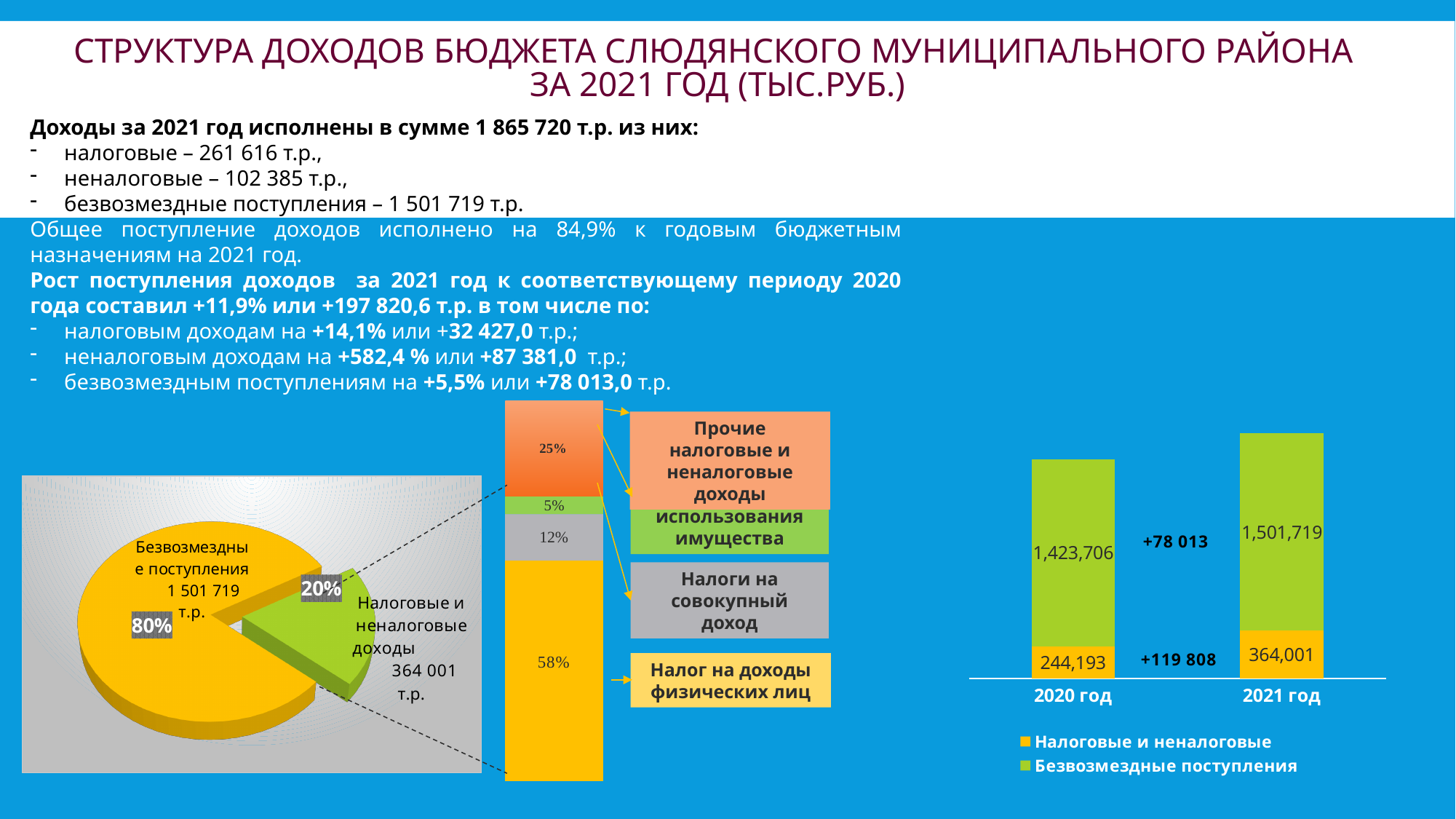
In the bar chart on the right, what is the value for Налоговые и неналоговые in 2020 год? 244,193 How many segments does the stacked bar in the middle of the slide have? 4 What kind of chart is the chart on the left of the slide? Pie chart In the bar chart on the right, by how much did Безвозмездные поступления increase from 2020 год to 2021 год? 78 013 How many series does the legend of the bar chart on the right list? 2 In the pie chart on the left, what value is shown for Налоговые и неналоговые доходы? 364 001 т.р. In the bar chart on the right, do the values for Налоговые и неналоговые rise or fall from 2020 год to 2021 год? Rise In the stacked bar in the middle of the slide, what percentage is shown for Налог на доходы физических лиц? 58% In the bar chart on the right, what is the total of the stacked bar for 2021 год? 1,865,720 In the pie chart on the left, what share of the pie is Безвозмездные поступления? 80% In the stacked bar in the middle of the slide, which segment has the smallest percentage? использования имущества In the bar chart on the right, what is the value for Безвозмездные поступления in 2021 год? 1,501,719